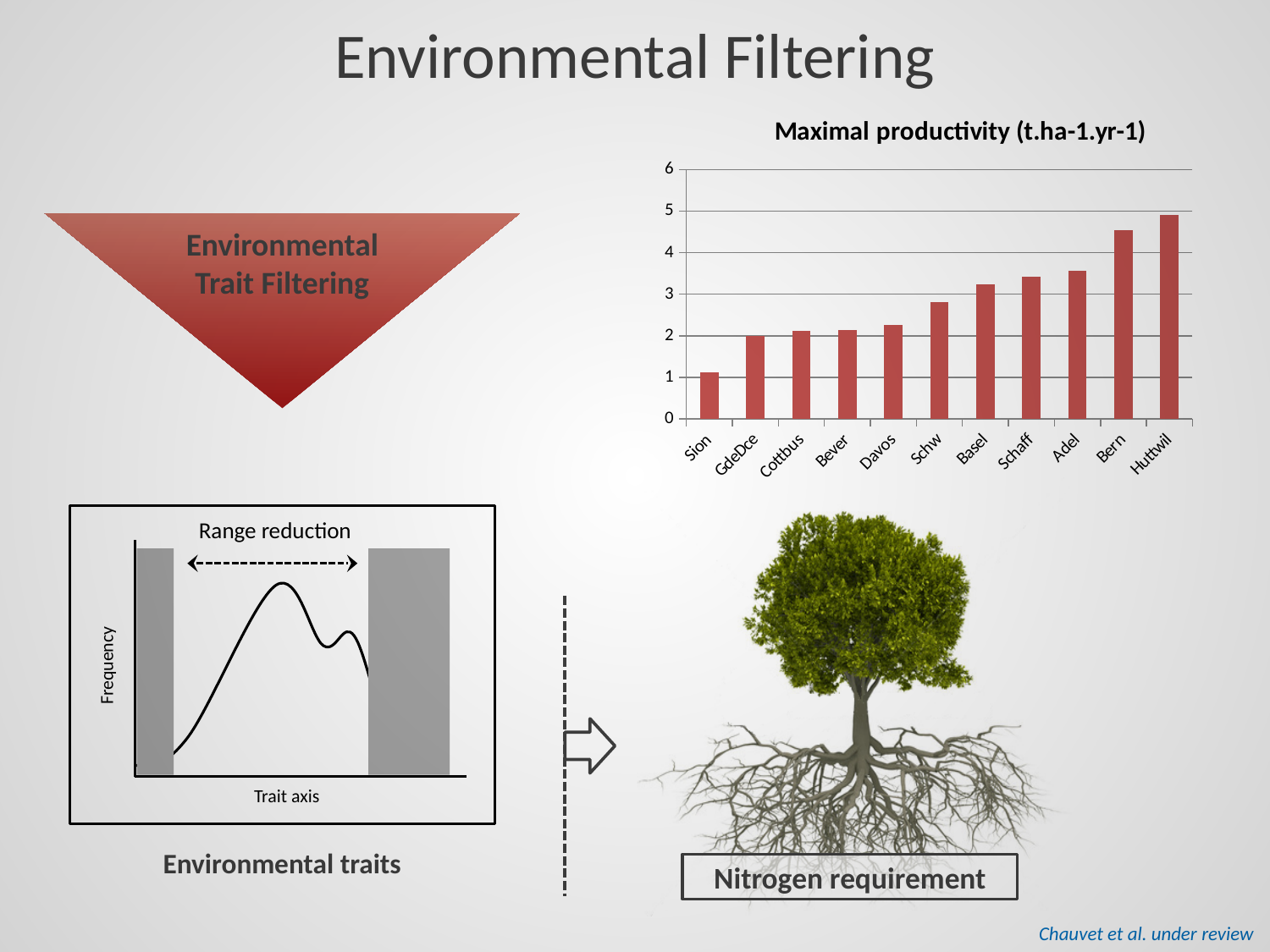
What kind of chart is used to show Maximal productivity (t.ha-1.yr-1)? bar chart In the Maximal productivity chart, is the value for Bern greater or less than 4? greater Which site has the lowest maximal productivity in the bar chart? Sion In the Maximal productivity chart, which site has the larger value, Bern or Adel? Bern Do the bars in the Maximal productivity chart rise or fall from left to right? rise Which site has the highest maximal productivity in the bar chart? Huttwil How many sites are shown on the x axis of the Maximal productivity chart? 11 In the Maximal productivity chart, is the value for Schw greater or less than 3? less What is the title of the bar chart on the slide? Maximal productivity (t.ha-1.yr-1) In the Maximal productivity chart, is the value for Huttwil greater or less than 4? greater In the Maximal productivity chart, which site has the larger value, Sion or Basel? Basel